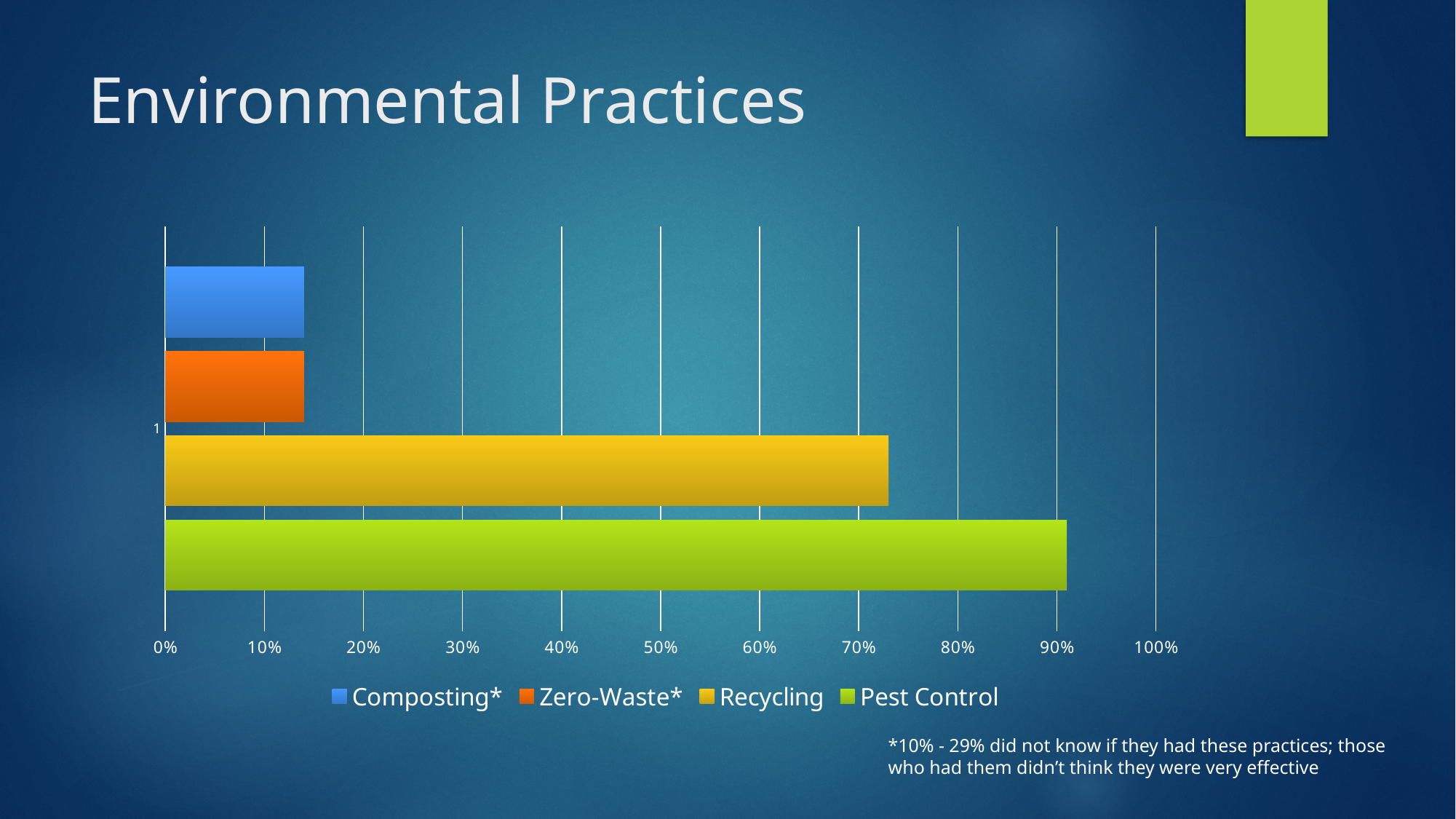
Which series is shown in green in the legend? Pest Control Which series has the highest value? Pest Control Is the value for Recycling greater or less than 60%? greater Is the value for Recycling greater or less than 80%? less Is the value for Pest Control greater or less than 80%? greater Which is larger, the value for Composting* or the value for Recycling? Recycling Which is larger, the value for Recycling or the value for Pest Control? Pest Control What kind of chart is shown on the slide? bar chart How many series does the legend list? 4 What is the title of the slide containing the chart? Environmental Practices